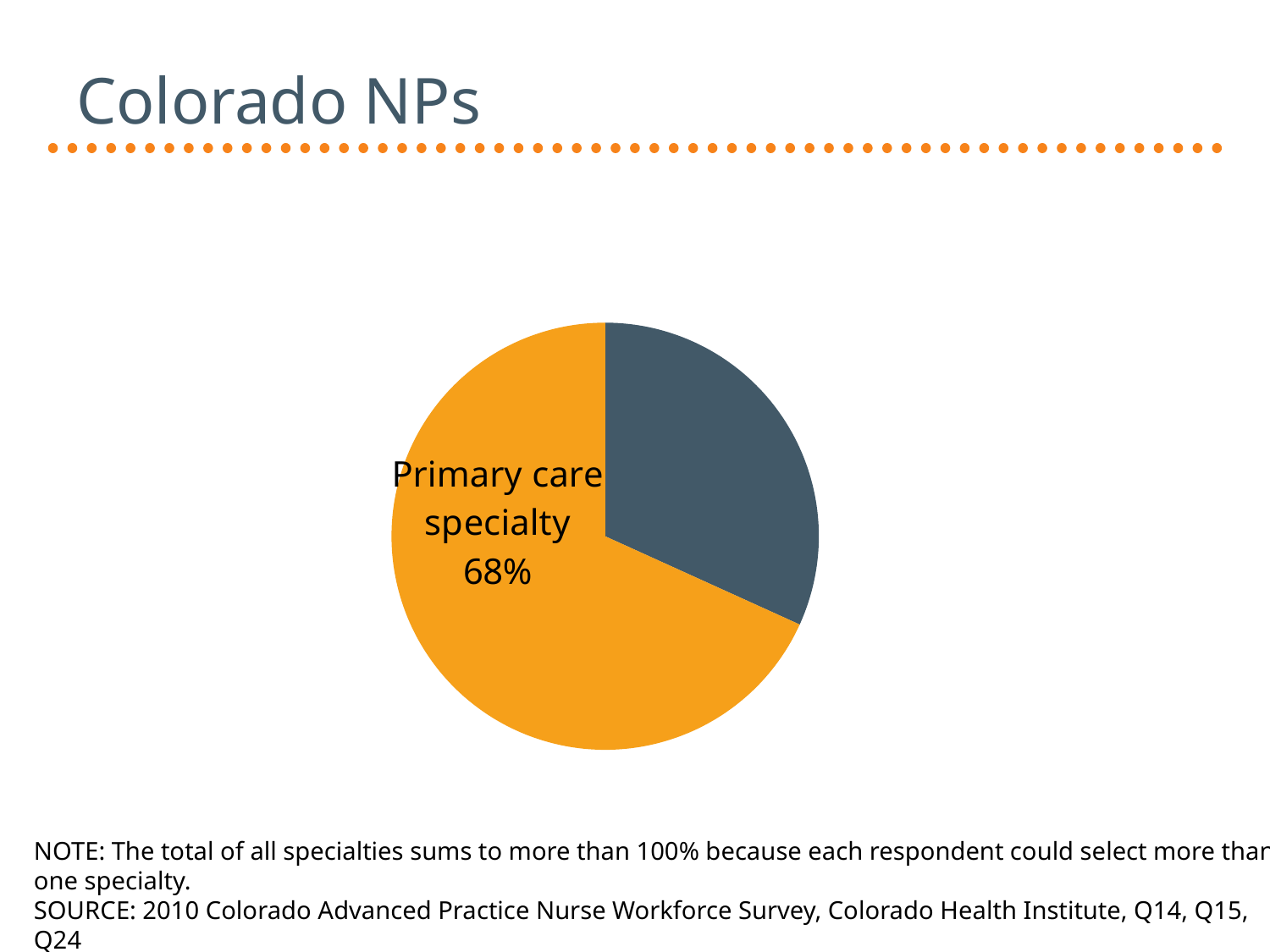
How many slices does the pie chart have? 2 What percentage of the pie is labelled "Primary care specialty"? 68% What is the title of the slide containing the pie chart? Colorado NPs Is the "Primary care specialty" slice greater or less than 50% of the pie? greater What kind of chart is shown on the slide? pie chart Which slice of the pie chart is larger, the "Primary care specialty" slice or the unlabelled dark slice? Primary care specialty Which slice of the pie chart is the largest? Primary care specialty What colour is the "Primary care specialty" slice? orange